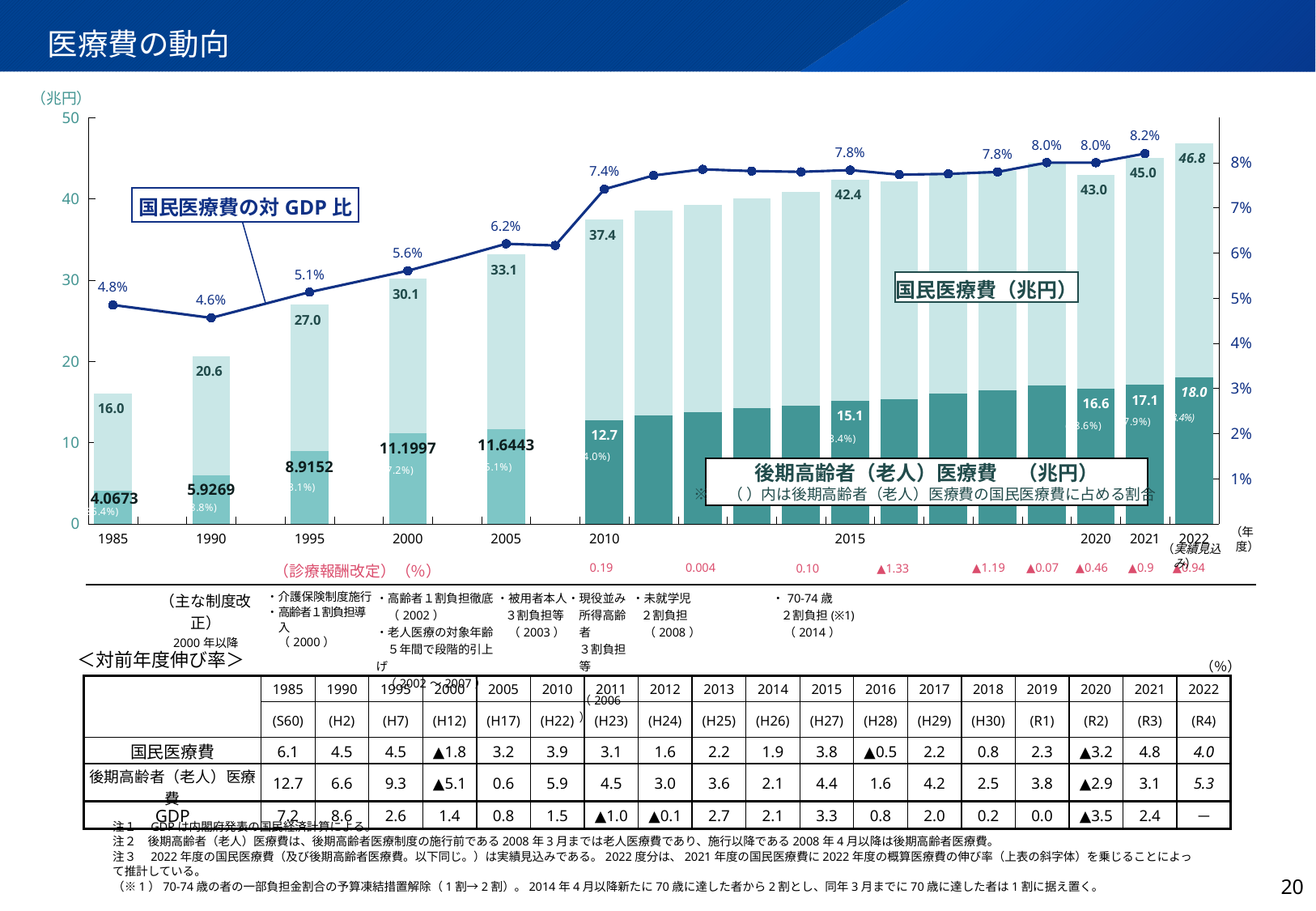
What is the 国民医療費の対GDP比 (ratio to GDP) shown for 1985? 4.8% Does the 国民医療費 value generally rise or fall from 1985 to 2022? rise Is the 国民医療費 value for 2015 greater or less than 40? greater Which year has the lowest 国民医療費の対GDP比 in the chart? 1990 What is the difference between the 国民医療費 values for 2021 and 2020? 2.0 What is the value of 後期高齢者（老人）医療費 for 2022 (実績見込み)? 18.0 Which year has the highest 国民医療費 value in the chart? 2022 What is the value of 後期高齢者（老人）医療費 (late-elderly medical expenses, 兆円) for 2021? 17.1 Which year has the larger 国民医療費 value, 2000 or 2005? 2005 What is the difference between the 国民医療費の対GDP比 for 2021 and 2010? 0.8% What is the value of 国民医療費 (national medical expenses, 兆円) for 2010? 37.4 What kind of chart is used on this slide? Bar chart combined with a line chart